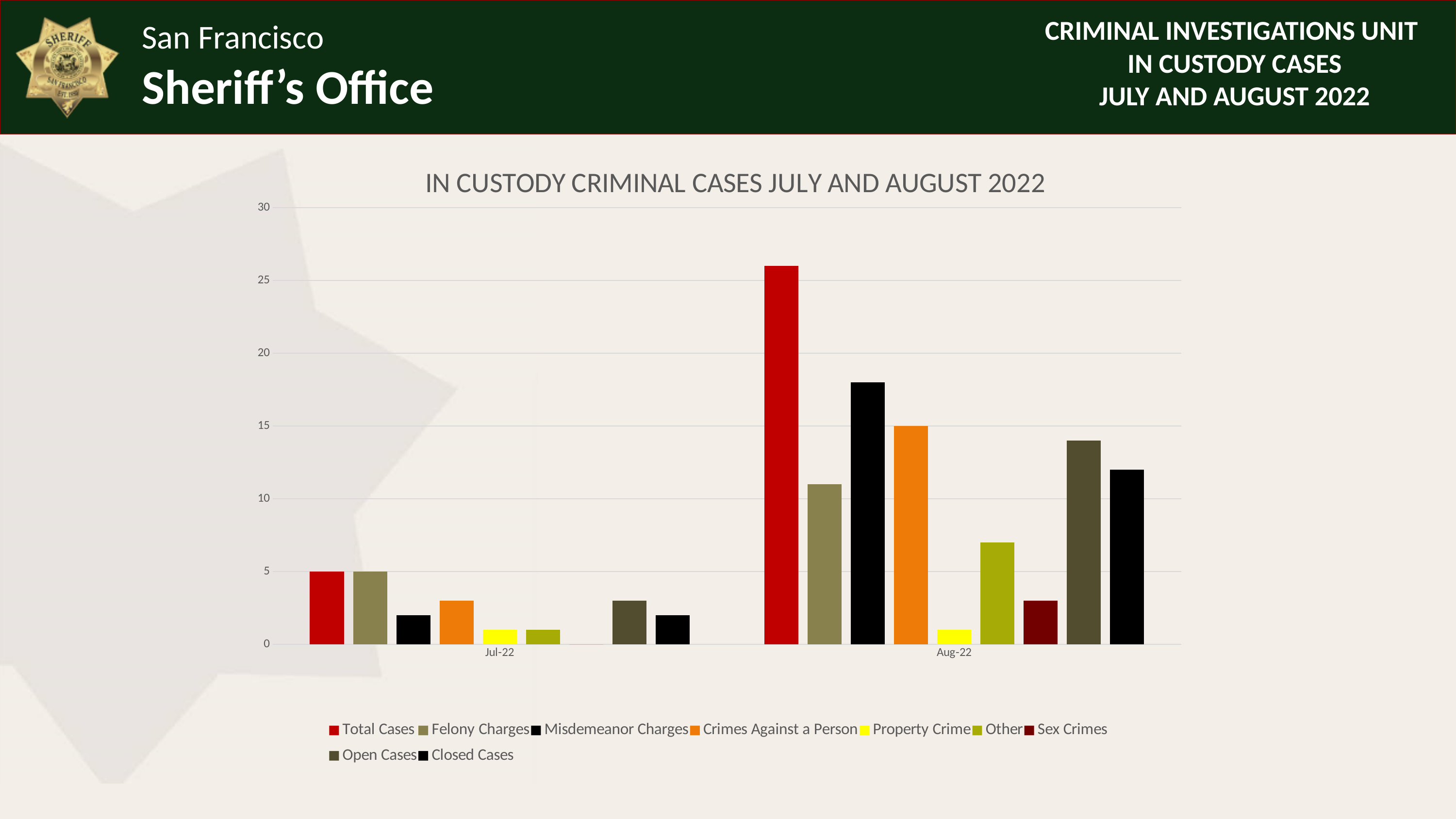
How many series does the legend list? 9 Is the value for Total Cases in Aug-22 greater or less than 25? greater What kind of chart is shown on the slide? bar chart Is the value for Misdemeanor Charges in Aug-22 greater or less than 15? greater Do Total Cases rise or fall from Jul-22 to Aug-22? rise How many month categories are shown on the x axis? 2 Is the value for Open Cases in Aug-22 greater or less than 15? less Which series has the highest value in Aug-22? Total Cases Which is larger in Aug-22, Felony Charges or Misdemeanor Charges? Misdemeanor Charges What is the value for Total Cases in Jul-22? 5 What is the title of the chart? IN CUSTODY CRIMINAL CASES JULY AND AUGUST 2022 What is the value for Crimes Against a Person in Aug-22? 15